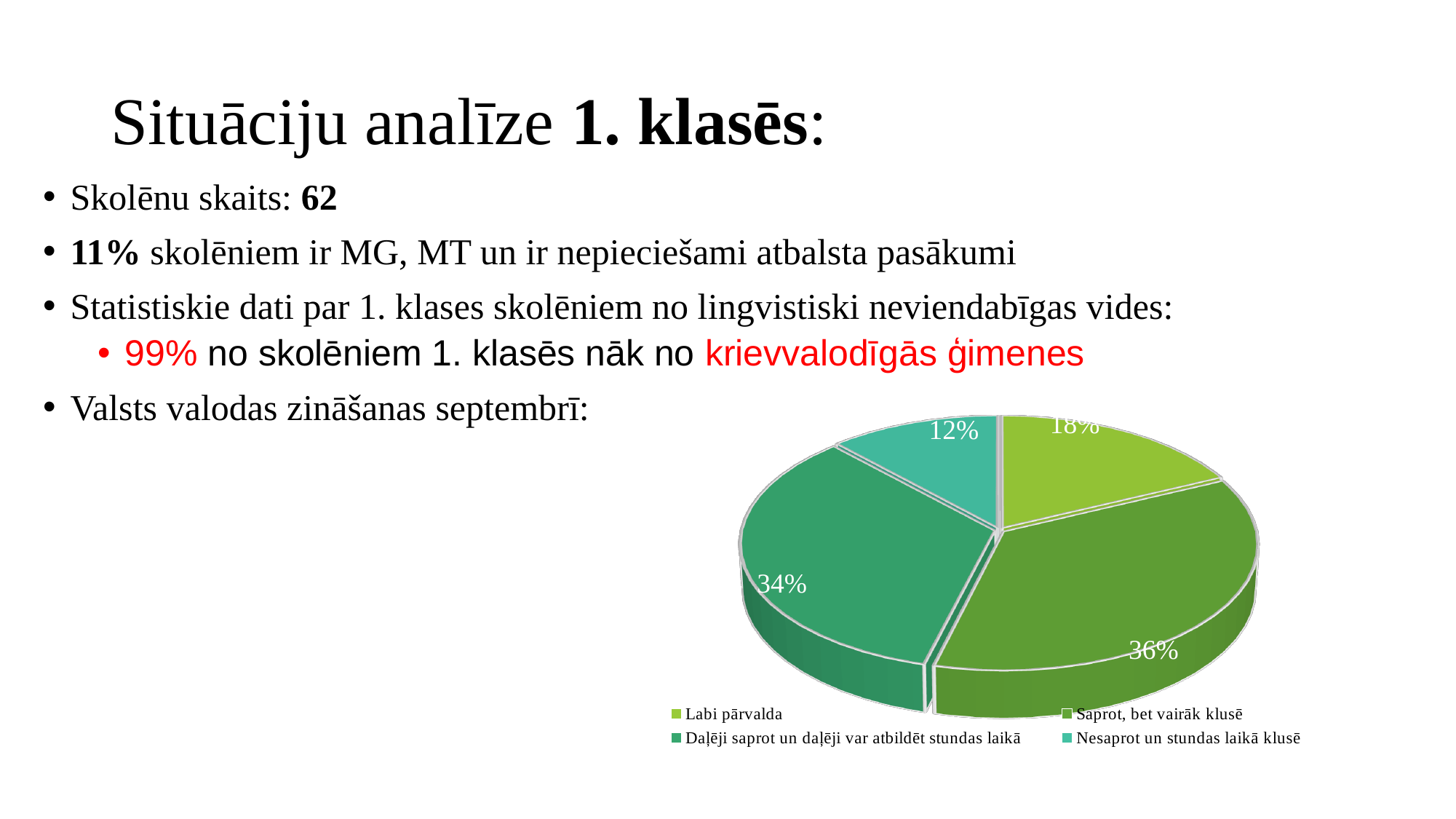
What is the difference in percentage points between 'Labi pārvalda' and 'Nesaprot un stundas laikā klusē'? 6 What percentage of the pie chart is 'Labi pārvalda'? 18% Which is larger in the pie chart: 'Labi pārvalda' or 'Daļēji saprot un daļēji var atbildēt stundas laikā'? Daļēji saprot un daļēji var atbildēt stundas laikā What percentage of the pie chart is 'Daļēji saprot un daļēji var atbildēt stundas laikā'? 34% What kind of chart is shown on the slide? pie chart What percentage of the pie chart is 'Saprot, bet vairāk klusē'? 36% Which category has the smallest share of the pie chart? Nesaprot un stundas laikā klusē Which legend entry is shown in the lightest green colour in the pie chart? Labi pārvalda Which category has the largest share of the pie chart? Saprot, bet vairāk klusē How many slices does the pie chart have? 4 What percentage of the pie chart is 'Nesaprot un stundas laikā klusē'? 12% How many entries does the legend of the pie chart list? 4